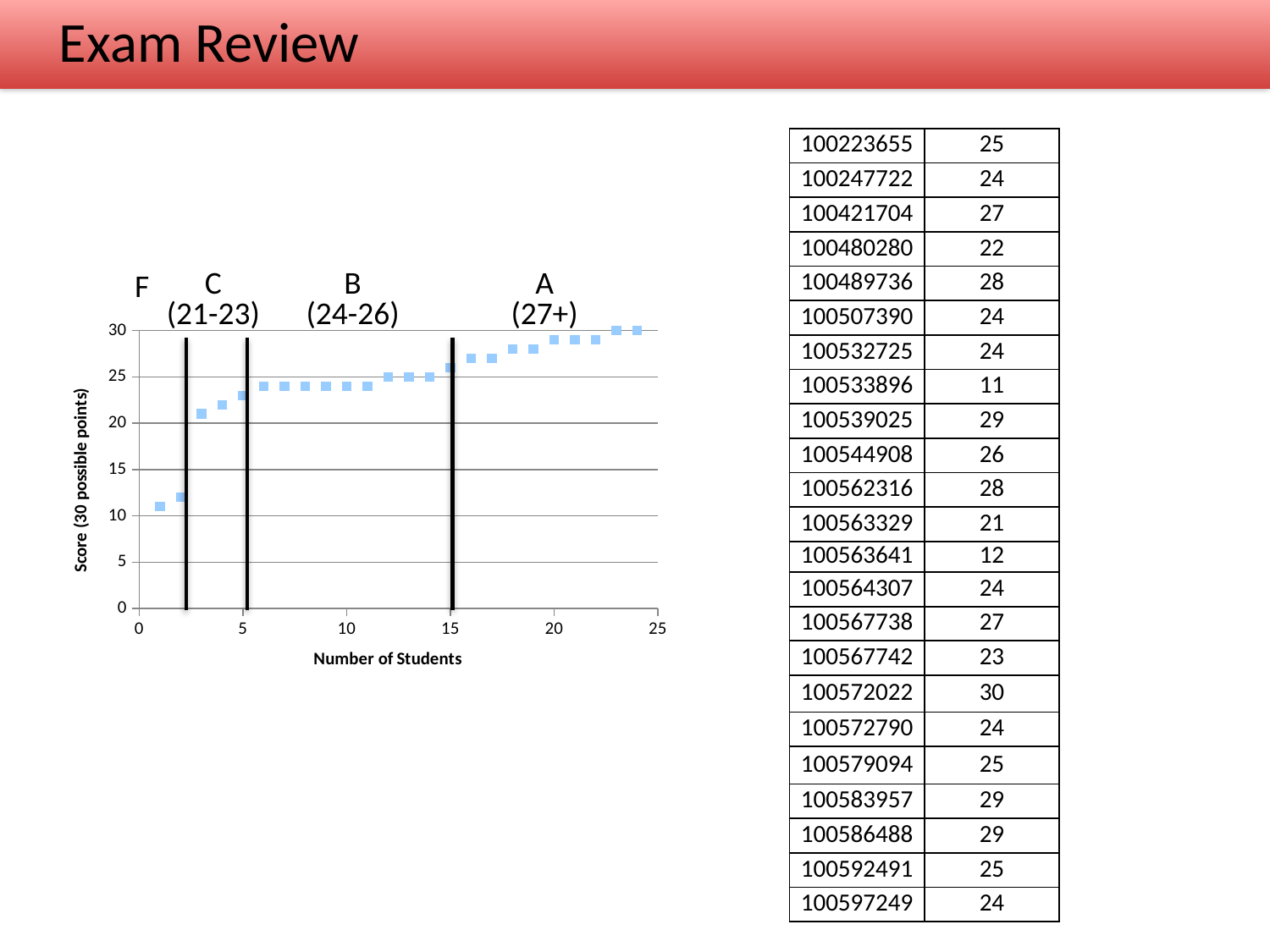
What is the title of the y axis of the chart? Score (30 possible points) Do the plotted scores rise or fall as the number of students increases along the x axis? rise Is the score of the point at x = 20 greater or less than 25? greater What is the title of the x axis of the chart? Number of Students What kind of chart is shown on the slide? scatter chart Is the score of the first (leftmost) plotted point greater or less than 15? less Is the score of the last (rightmost) plotted point greater or less than 25? greater Is the score of the point at x = 17 larger or smaller than the score of the point at x = 1? larger Which plotted point has the lowest score, the leftmost point or the rightmost point? the leftmost point What is the highest value shown on the y axis of the chart? 30